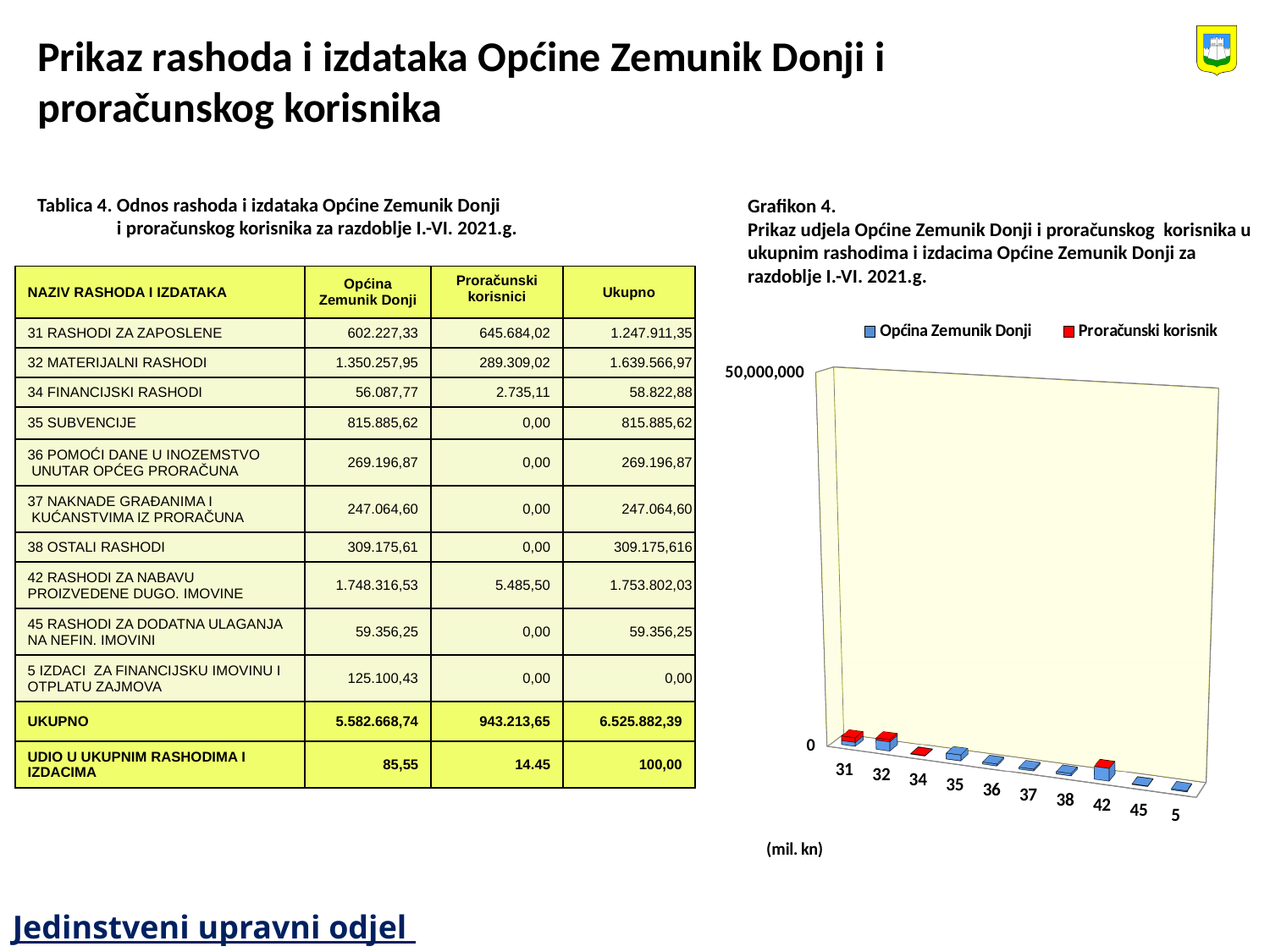
In Grafikon 4, which series is shown in blue? Općina Zemunik Donji How many categories are shown on the x axis of Grafikon 4? 10 In Grafikon 4, is the value for category 42 greater or less than 50,000,000? less What is the first category label on the x axis of Grafikon 4? 31 In Grafikon 4, is the value for category 31 greater or less than 50,000,000? less What is the highest tick value shown on the y axis of Grafikon 4? 50,000,000 What kind of chart is Grafikon 4? bar chart How many series does the legend of Grafikon 4 list? 2 What is the last category label on the x axis of Grafikon 4? 5 In Grafikon 4, which series is shown in red? Proračunski korisnik